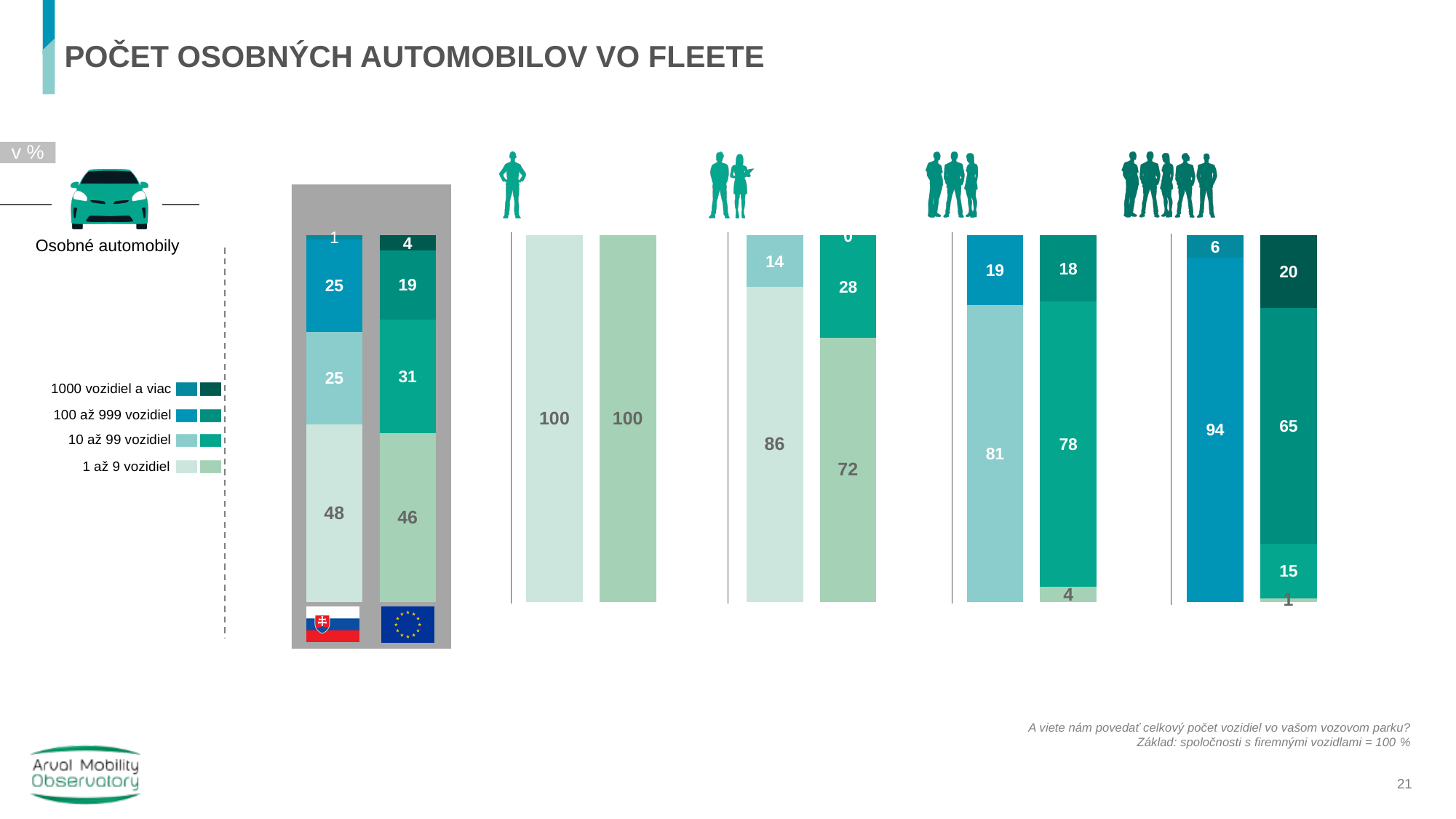
In the group of bars under the two-person icon, what is the value for '10 až 99 vozidiel' in the EU (green) bar? 28 How many fleet-size categories does the legend list? 4 What kind of chart is shown on the slide? stacked bar chart In the group of bars under the three-person icon, what is the value for '100 až 999 vozidiel' in the Slovak (blue) bar? 19 In the bars with the Slovak and EU flags, which bar has the larger value for '1 až 9 vozidiel', Slovakia or EU? Slovakia In the bars with the Slovak and EU flags, what is the value for '10 až 99 vozidiel' in the EU bar? 31 What is the title of the slide? POČET OSOBNÝCH AUTOMOBILOV VO FLEETE In the bars with the Slovak and EU flags, what is the value for '1 až 9 vozidiel' in the Slovak bar? 48 In the bars with the Slovak and EU flags, what is the total of the EU bar's segments? 100 In the bars with the Slovak and EU flags, what is the difference between the Slovak and EU values for '100 až 999 vozidiel'? 6 In the bars with the Slovak and EU flags, what is the value for '1000 vozidiel a viac' in the EU bar? 4 In the group of bars under the five-person icon, what is the value for '100 až 999 vozidiel' in the EU (green) bar? 65